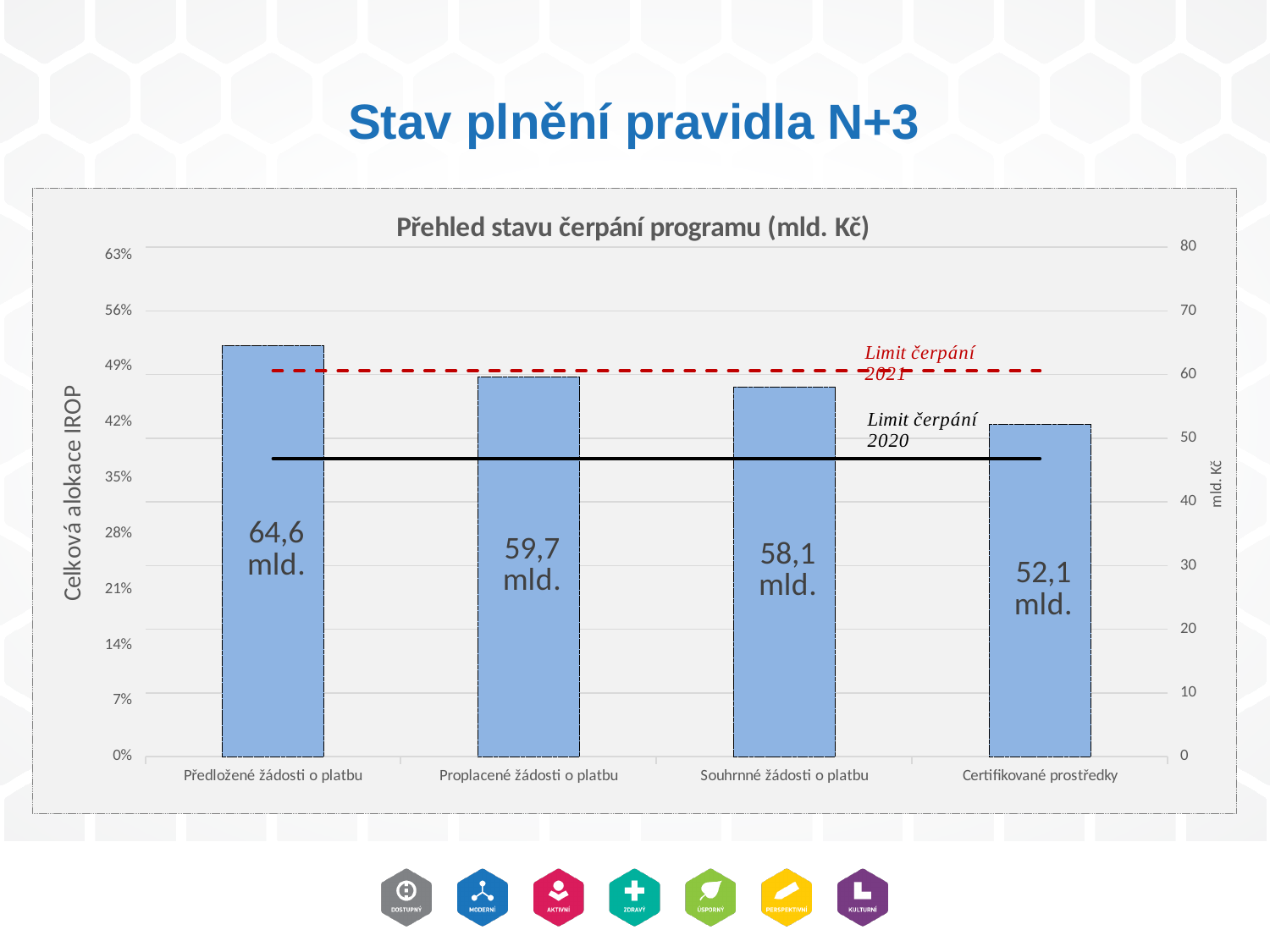
What is the difference between Předložené žádosti o platbu and Certifikované prostředky? 12,5 mld. Is the value for Souhrnné žádosti o platbu greater or less than 60 on the right axis? less What value is shown for Certifikované prostředky? 52,1 mld. What is the title of the chart? Přehled stavu čerpání programu (mld. Kč) Which category has the highest value? Předložené žádosti o platbu What value is shown for Souhrnné žádosti o platbu? 58,1 mld. Which category has the lowest value? Certifikované prostředky Do the bar values rise or fall from left to right? fall How many bars are plotted in the chart? 4 What value is shown for Předložené žádosti o platbu? 64,6 mld. What kind of chart is shown? bar chart Which is larger, Proplacené žádosti o platbu or Souhrnné žádosti o platbu? Proplacené žádosti o platbu